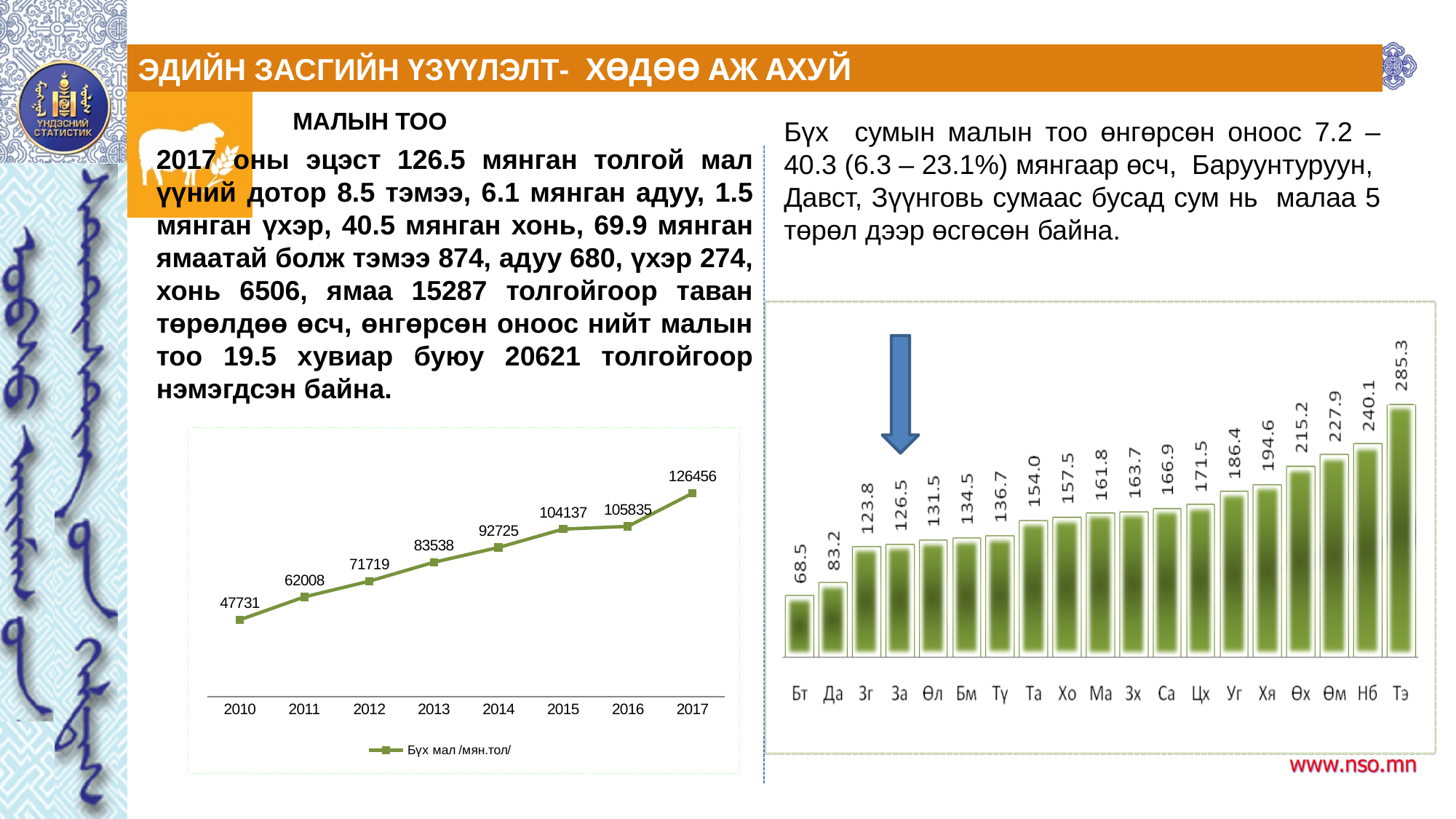
In the line chart on the left, do the values rise or fall from 2010 to 2017? rise In the line chart on the left, how many years are plotted? 8 In the line chart on the left, what is the difference between the 2017 and 2016 values? 20621 In the bar chart on the right, what is the value for За? 126.5 In the bar chart on the right, which category has the highest value? Тэ In the bar chart on the right, how many categories are shown? 19 In the line chart on the left, what is the value for 2017? 126456 In the line chart on the left, what is the value for 2010? 47731 What kind of chart is the chart on the right of the slide? bar chart In the line chart on the left, what series name does the legend show? Бүх мал /мян.тол/ In the bar chart on the right, which category has the lowest value? Бт In the bar chart on the right, what is the difference between the values for Тэ and Нб? 45.2